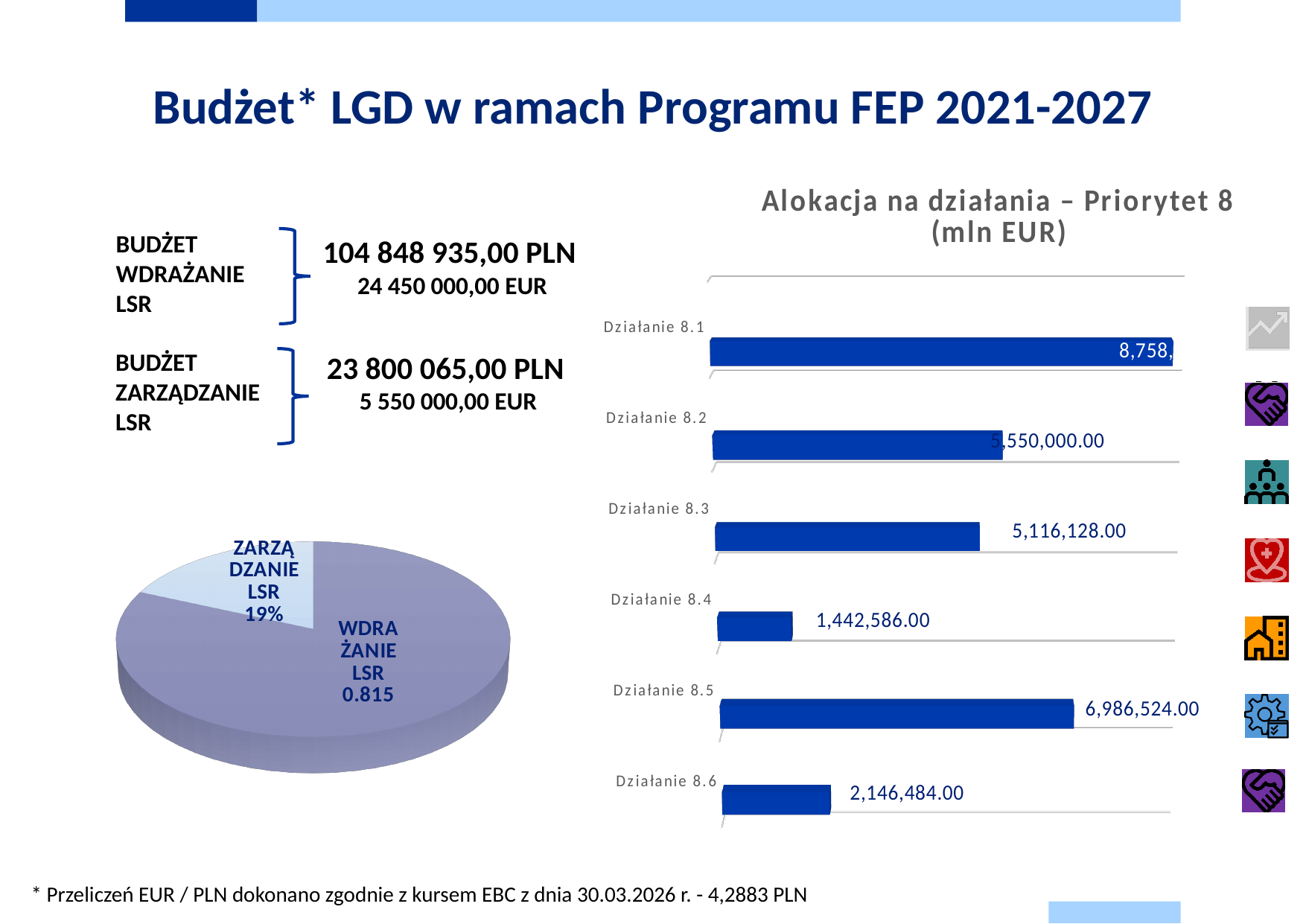
How many categories are shown in the bar chart 'Alokacja na działania – Priorytet 8 (mln EUR)'? 6 In the bar chart 'Alokacja na działania – Priorytet 8 (mln EUR)', what is the value for Działanie 8.5? 6,986,524.00 In the bar chart 'Alokacja na działania – Priorytet 8 (mln EUR)', which category has the lowest value? Działanie 8.4 In the bar chart 'Alokacja na działania – Priorytet 8 (mln EUR)', what is the value for Działanie 8.4? 1,442,586.00 In the bar chart 'Alokacja na działania – Priorytet 8 (mln EUR)', what is the difference between the values for Działanie 8.5 and Działanie 8.3? 1,870,396.00 In the bar chart 'Alokacja na działania – Priorytet 8 (mln EUR)', what is the value for Działanie 8.3? 5,116,128.00 In the bar chart 'Alokacja na działania – Priorytet 8 (mln EUR)', what is the value for Działanie 8.6? 2,146,484.00 In the bar chart 'Alokacja na działania – Priorytet 8 (mln EUR)', which is larger: Działanie 8.2 or Działanie 8.3? Działanie 8.2 What kind of chart is the chart on the left of the slide? pie chart In the bar chart 'Alokacja na działania – Priorytet 8 (mln EUR)', which category has the highest value? Działanie 8.1 What kind of chart is the chart on the right titled 'Alokacja na działania – Priorytet 8 (mln EUR)'? bar chart In the pie chart on the left, what share is shown for ZARZĄDZANIE LSR? 19%